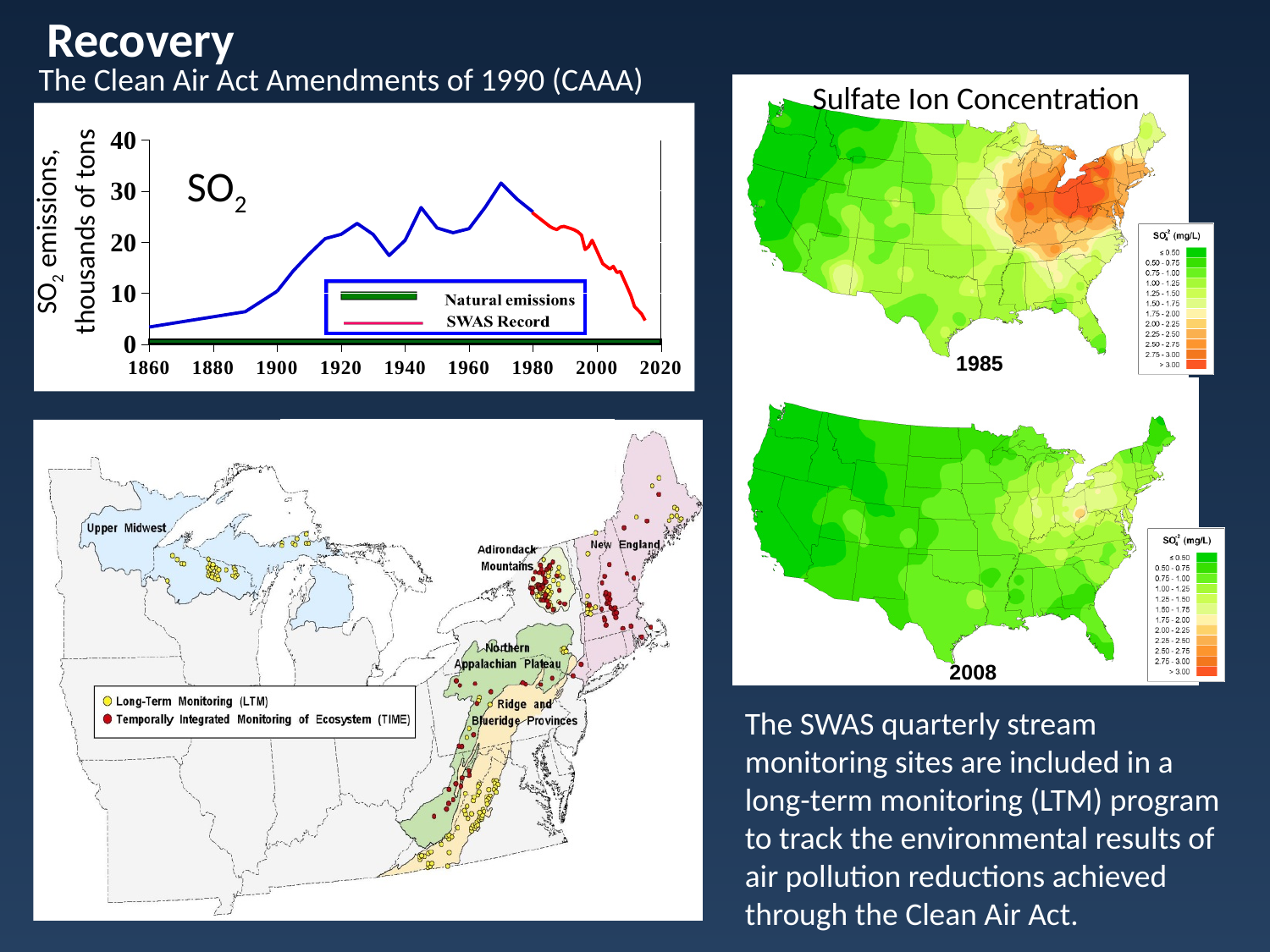
In the SO2 emissions chart, is the value at the right end of the red SWAS Record line (around 2015) greater or less than 10? less In the SO2 emissions chart, is the value for 1980 larger or smaller than the value for 1940? larger What kind of chart is the SO2 emissions chart on the left of the slide? line chart In the SO2 emissions chart, is the value for 1860 greater or less than 10? less In the SO2 emissions chart, is the value for 1980 greater or less than 20? greater In the SO2 emissions chart, does the line rise or fall between 1970 and 2015? fall In the SO2 emissions chart, does the line rise or fall between 1860 and 1970? rise Which of the two sulfate ion concentration maps, 1985 or 2008, shows the larger area of high (orange) concentration? 1985 In the SO2 emissions chart, how many entries does the legend list? 2 In the SO2 emissions chart, at which x-axis tick does the line reach its highest point? 1970 What is the y-axis label of the SO2 emissions chart? SO2 emissions, thousands of tons